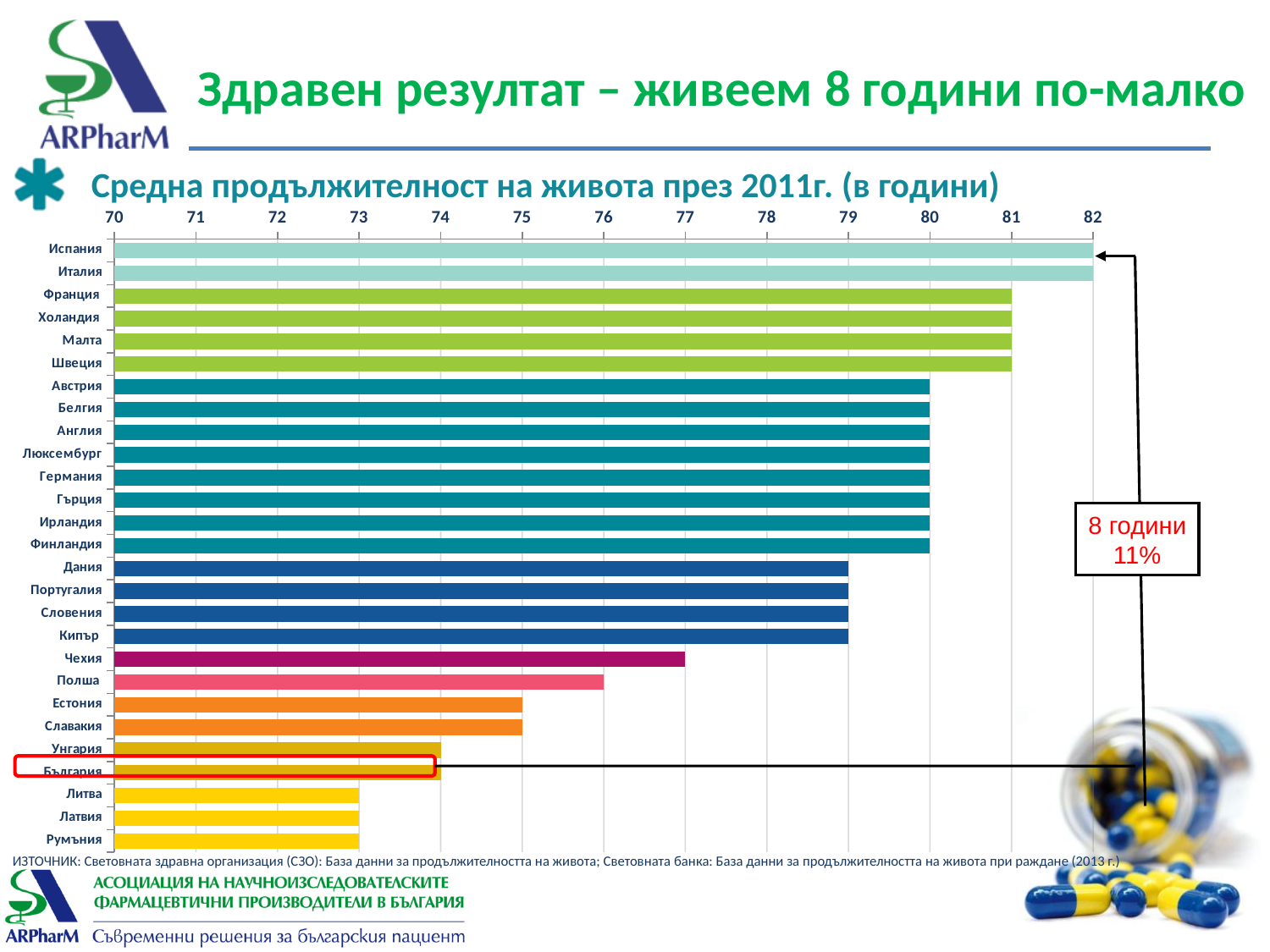
What is the title of the chart? Средна продължителност на живота през 2011г. (в години) What is the average life expectancy shown for Полша? 76 What is the difference in life expectancy between Испания and България? 8 Is the value for Естония greater or less than 76? less What kind of chart is shown on the slide? bar chart What is the average life expectancy shown for България? 74 What is the average life expectancy shown for Испания? 82 What text is shown in the boxed annotation on the right of the chart? 8 години 11% What is the average life expectancy shown for Чехия? 77 How many countries are listed on the chart? 27 Which has a higher life expectancy, Франция or Дания? Франция Which country has the lowest bar on the chart? Литва, Латвия and Румъния (tied at 73)